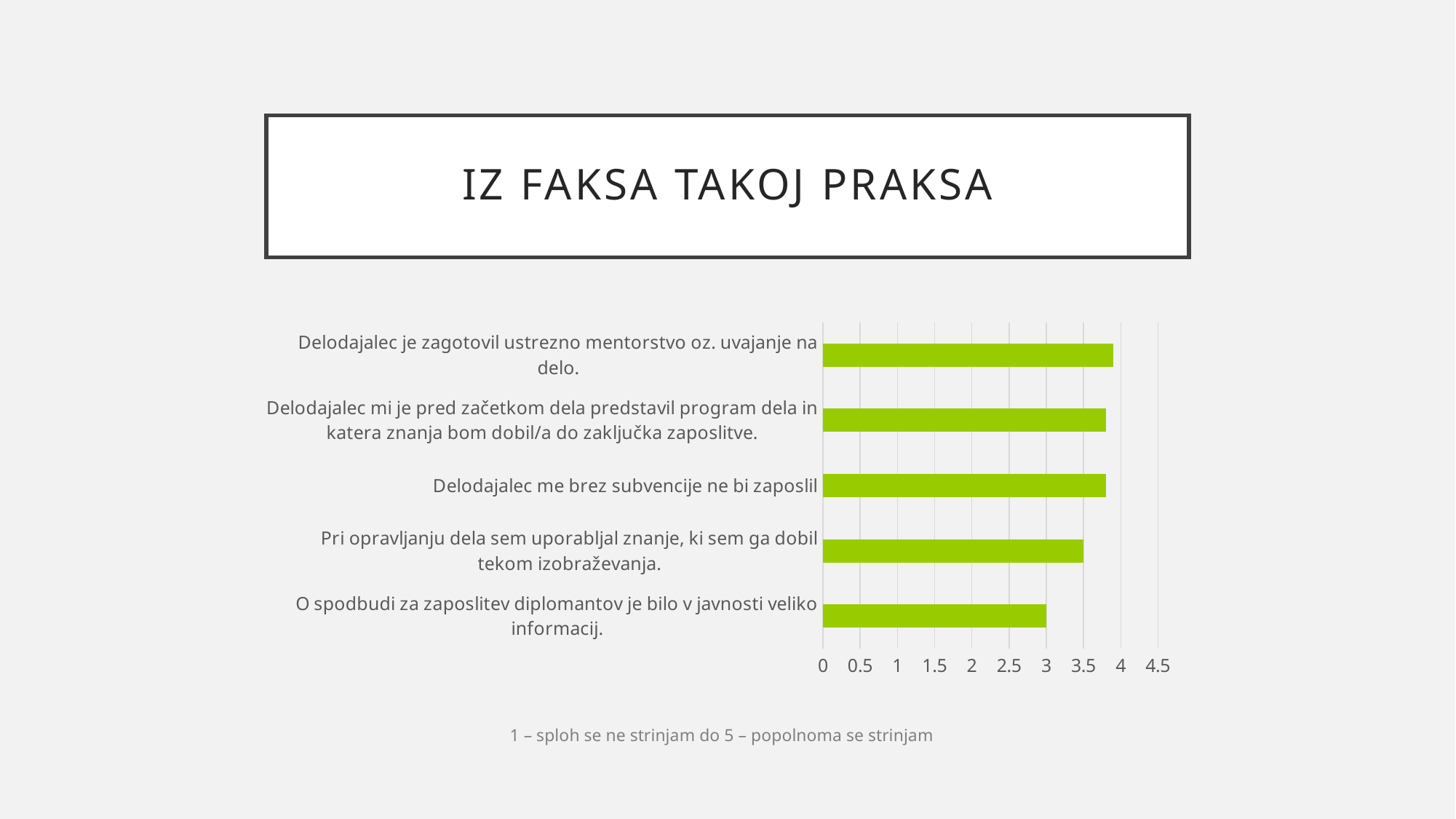
What is the value for "O spodbudi za zaposlitev diplomantov je bilo v javnosti veliko informacij."? 3 How many categories (statements) are plotted in the chart? 5 What is the highest value shown on the chart's horizontal axis? 4.5 What is the title of the slide containing the chart? IZ FAKSA TAKOJ PRAKSA Is the value for "Delodajalec je zagotovil ustrezno mentorstvo oz. uvajanje na delo." greater or less than 3.5? greater Is the value for "Delodajalec me brez subvencije ne bi zaposlil" greater or less than 4? less What kind of chart is shown on the slide? bar chart Which statement has the lowest value in the chart? O spodbudi za zaposlitev diplomantov je bilo v javnosti veliko informacij. Which has a larger value: "Delodajalec me brez subvencije ne bi zaposlil" or "Pri opravljanju dela sem uporabljal znanje, ki sem ga dobil tekom izobraževanja."? Delodajalec me brez subvencije ne bi zaposlil Is the value for "Delodajalec mi je pred začetkom dela predstavil program dela in katera znanja bom dobil/a do zaključka zaposlitve." greater or less than 3.5? greater What is the value for "Pri opravljanju dela sem uporabljal znanje, ki sem ga dobil tekom izobraževanja."? 3.5 Which has a larger value: "Delodajalec je zagotovil ustrezno mentorstvo oz. uvajanje na delo." or "O spodbudi za zaposlitev diplomantov je bilo v javnosti veliko informacij."? Delodajalec je zagotovil ustrezno mentorstvo oz. uvajanje na delo.